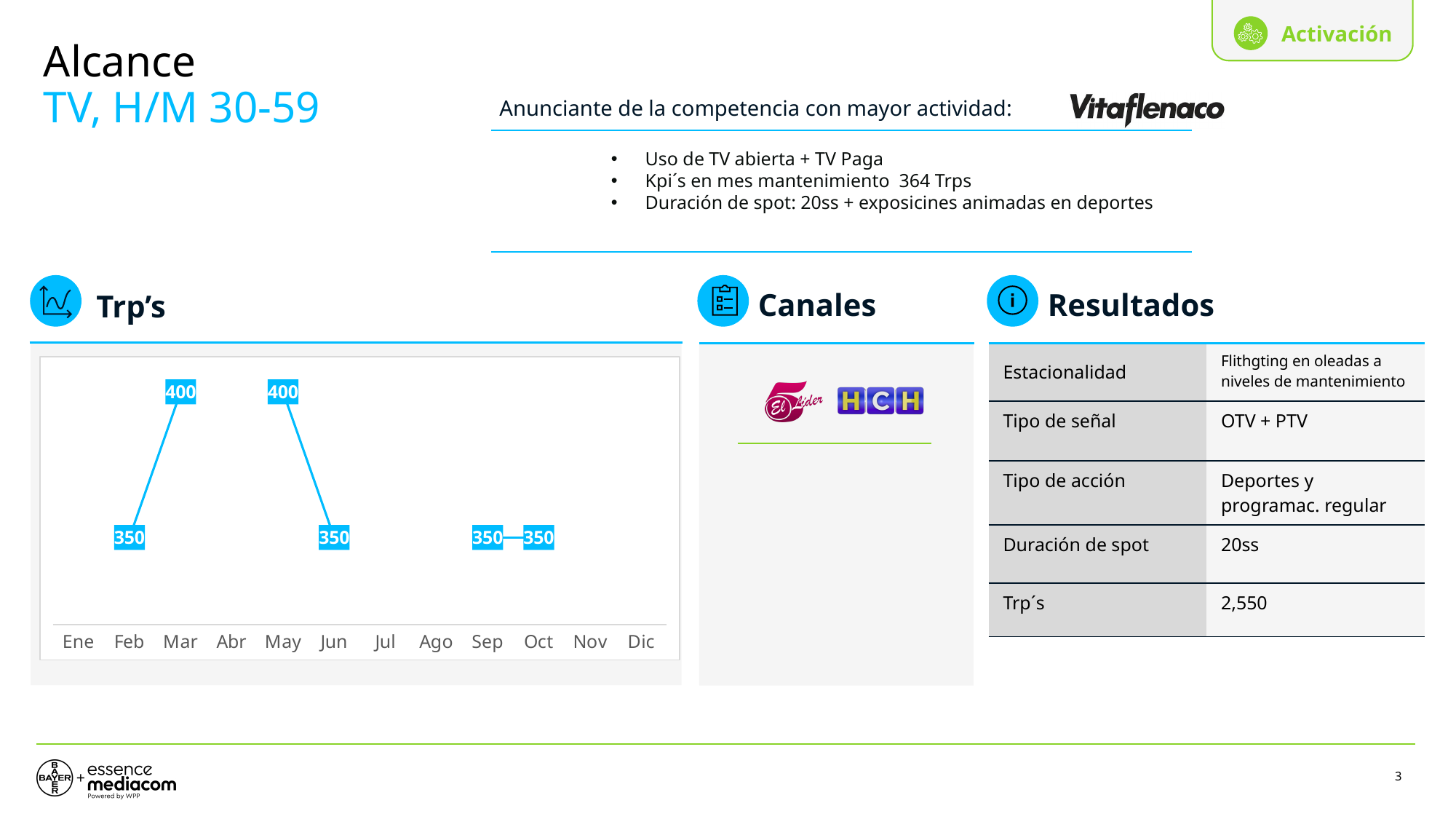
In the Trp's chart, what is the value for Jun? 350 In the Trp's chart, what is the highest value shown? 400 In the Trp's chart, what is the value for Feb? 350 How many months are listed on the x axis of the Trp's chart? 12 In the Trp's chart, what is the lowest value shown? 350 In the Trp's chart, what is the difference between the values for Mar and Feb? 50 How many data points have labels in the Trp's chart? 6 In the Trp's chart, what is the value for Mar? 400 In the Trp's chart, what is the value for Oct? 350 What kind of chart is the Trp's chart? Line chart In the Trp's chart, which is larger, the value for May or the value for Jun? May In the Trp's chart, does the value rise or fall from May to Jun? Fall